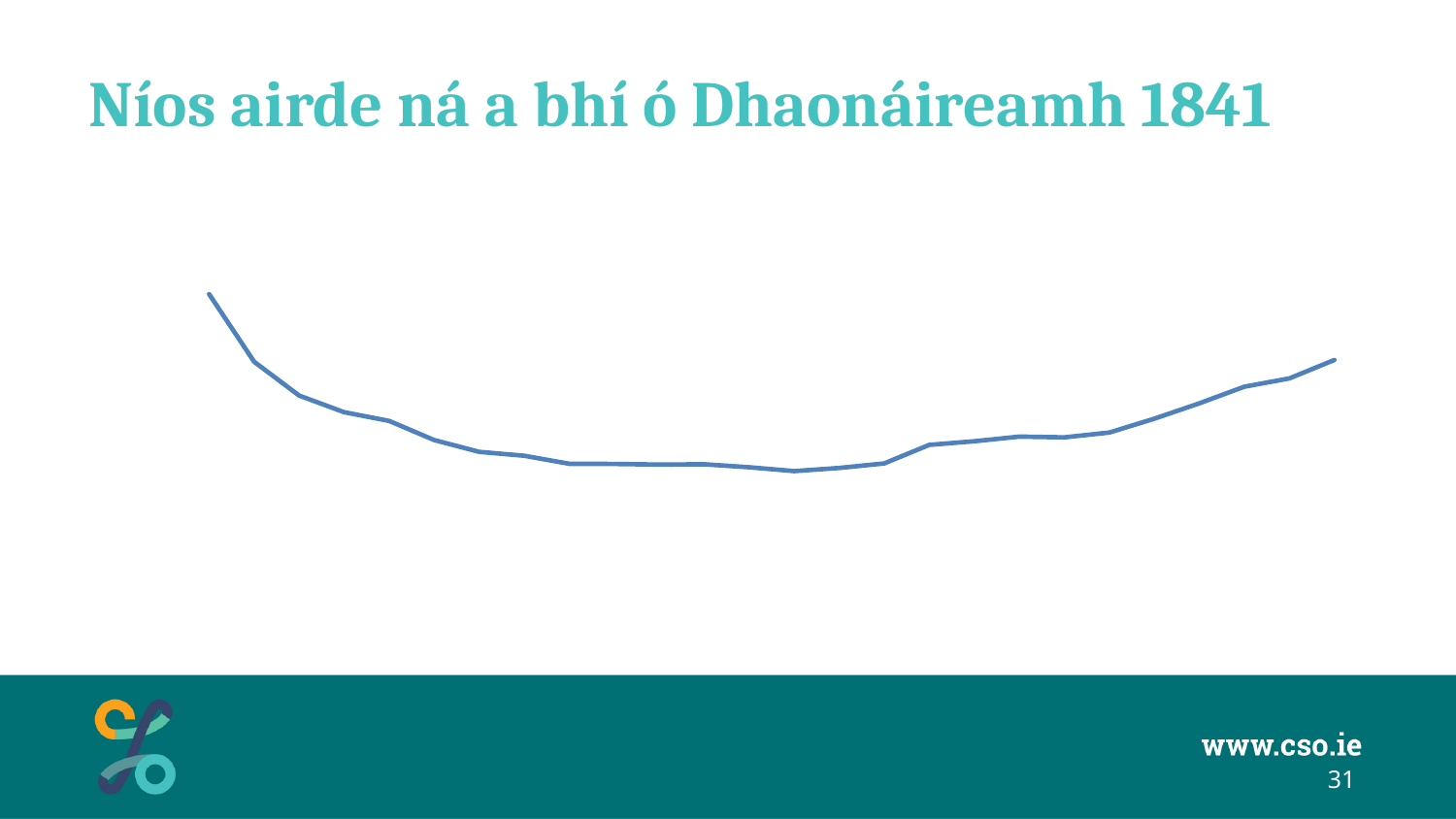
At the right-hand end of the chart, is the line rising or falling? rising What is the title of the slide containing the chart? Níos airde ná a bhí ó Dhaonáireamh 1841 What colour is the plotted line? blue How many lines are plotted on the chart? 1 Moving from left to right, does the line initially rise or fall? fall What kind of chart is shown on the slide? line chart Is the line's lowest point near the left edge, the middle, or the right edge of the chart? the middle